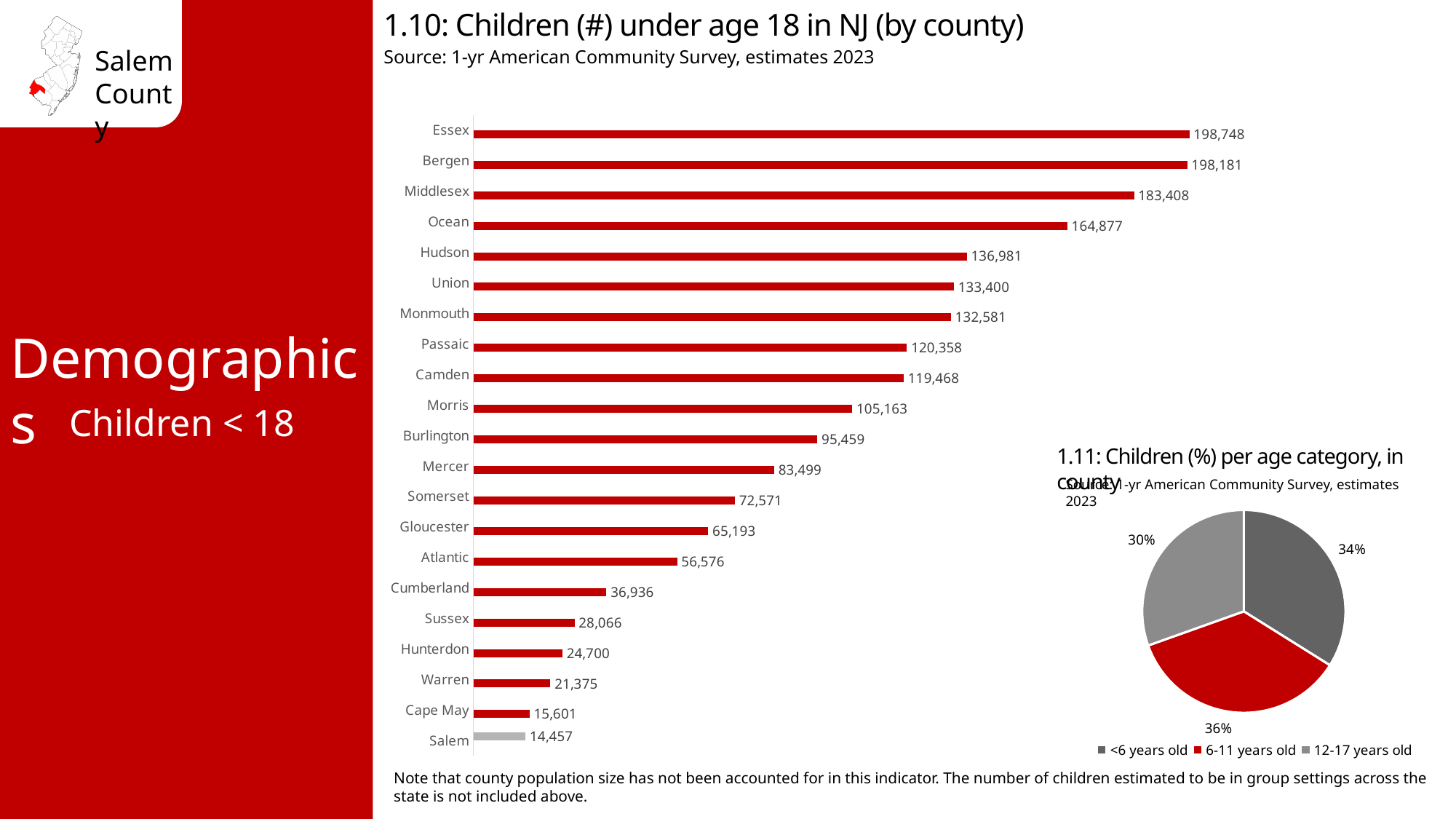
How many categories does the legend of chart 1.11 list? 3 What type of chart is chart 1.10? Bar chart In chart 1.10, how many counties are shown? 21 In chart 1.10, which county has the highest number of children under 18? Essex In chart 1.10, how many children under age 18 are in Salem County? 14,457 In chart 1.11, what colour is the slice for 6-11 years old? Red In chart 1.10, which county has more children under 18, Cumberland or Sussex? Cumberland In chart 1.10, what is the value for Gloucester? 65,193 In chart 1.11, which age category has the smallest share? 12-17 years old In chart 1.10, what is the difference between the values for Gloucester and Atlantic? 8,617 In chart 1.10, which county has the lowest number of children under 18? Salem In chart 1.11, what percentage of children in Salem County are 6-11 years old? 36%